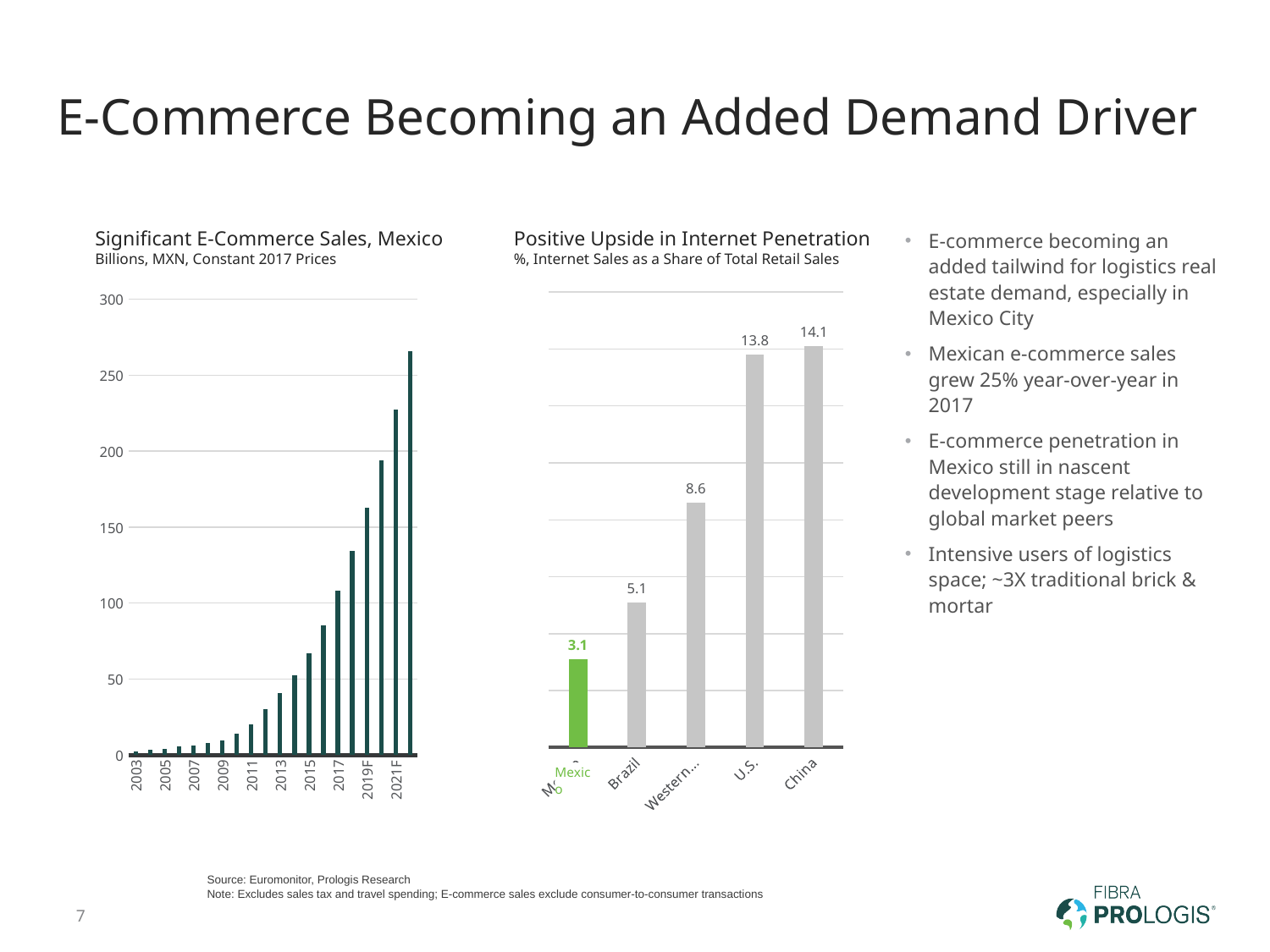
In the 'Significant E-Commerce Sales, Mexico' chart, is the value for 2021F greater or less than 250? less In the 'Positive Upside in Internet Penetration' chart, which is larger, the value for Brazil or the value for Mexico? Brazil In the 'Positive Upside in Internet Penetration' chart, what is the value for the U.S.? 13.8 In the 'Positive Upside in Internet Penetration' chart, what is the value for Brazil? 5.1 In the 'Positive Upside in Internet Penetration' chart, what is the difference between China's value and Mexico's value? 11.0 In the 'Significant E-Commerce Sales, Mexico' chart, is the value for 2015 greater or less than 100? less In the 'Positive Upside in Internet Penetration' chart, which country's bar is coloured green? Mexico In the 'Positive Upside in Internet Penetration' chart, which country has the lowest value? Mexico In the 'Positive Upside in Internet Penetration' chart, which country has the highest value? China In the 'Positive Upside in Internet Penetration' chart, what is the value for Mexico? 3.1 How many bars are shown in the 'Positive Upside in Internet Penetration' chart? 5 In the 'Significant E-Commerce Sales, Mexico' chart, do the values generally rise or fall from 2003 to 2021F? rise